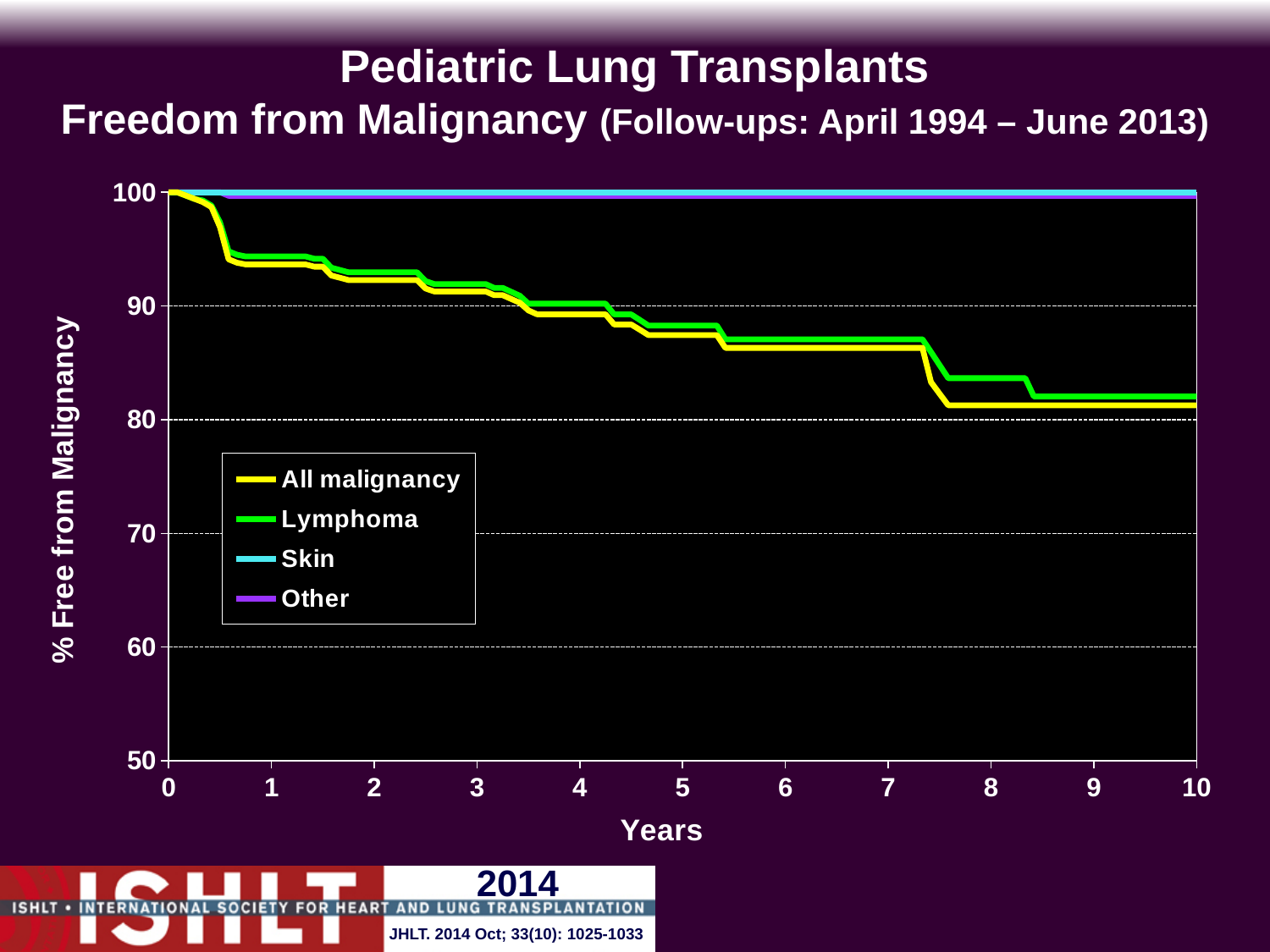
Does the All malignancy line rise or fall as years increase? Fall Is the value for All malignancy at 5 years greater or less than 90? less Is the value for All malignancy at 2 years greater or less than 90? greater Which series has the lowest value at 10 years? All malignancy What is the label of the y axis? % Free from Malignancy How many series does the legend list? 4 What kind of chart is shown on the slide? Line chart Is the value for Lymphoma at 10 years greater or less than 90? less Which series are listed in the legend? All malignancy, Lymphoma, Skin, Other How many tick marks are labelled on the x axis? 11 At 10 years, which is higher: Skin or All malignancy? Skin